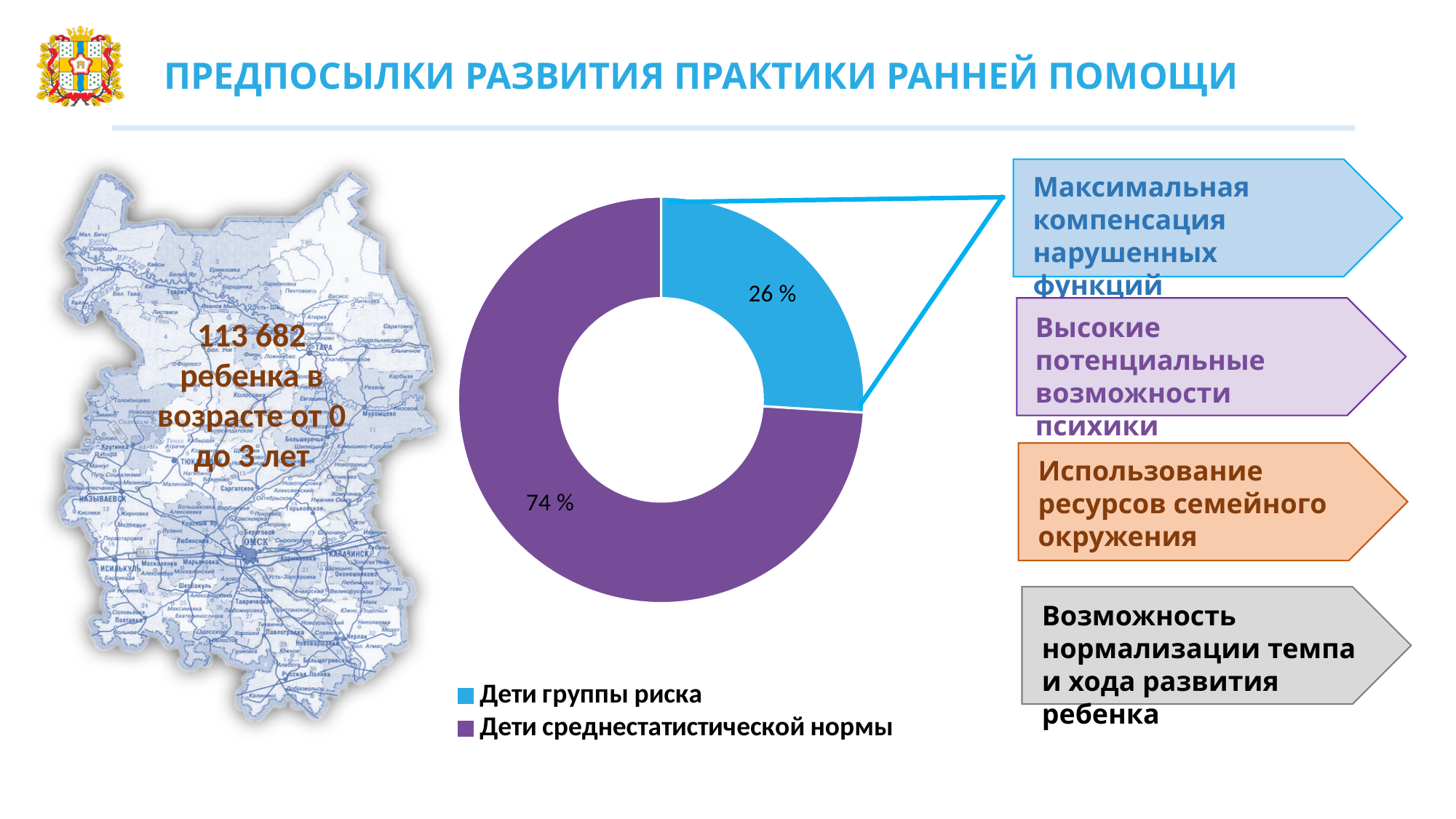
Which slice is larger: "Дети группы риска" or "Дети среднестатистической нормы"? Дети среднестатистической нормы Which category has the smallest share in the doughnut chart? Дети группы риска What percentage of the doughnut chart is labelled "Дети среднестатистической нормы"? 74 % Which category has the largest share in the doughnut chart? Дети среднестатистической нормы What percentage of the doughnut chart is labelled "Дети группы риска"? 26 % How many categories are shown in the doughnut chart? 2 What colour is the "Дети среднестатистической нормы" slice in the doughnut chart? Purple What colour is the "Дети группы риска" slice in the doughnut chart? Blue How many entries does the chart legend list? 2 What share of the doughnut chart does the "Дети группы риска" slice represent? 26 % What is the difference in percentage points between the "Дети среднестатистической нормы" slice and the "Дети группы риска" slice? 48 What type of chart is shown on the slide? Doughnut (pie) chart